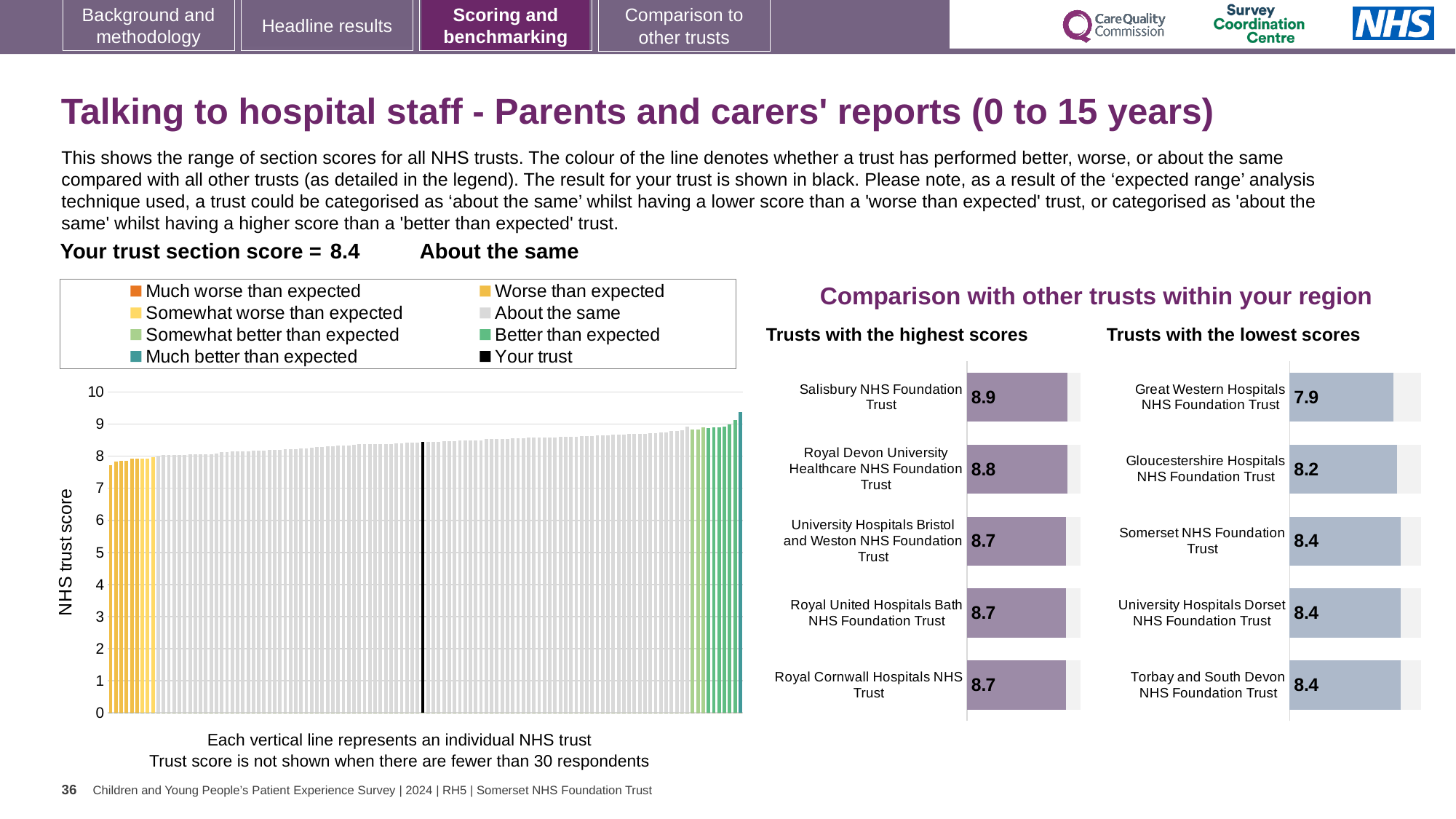
How many entries does the legend of the left-hand chart list? 8 In the 'Trusts with the highest scores' chart, what is the score for Salisbury NHS Foundation Trust? 8.9 In the 'Trusts with the lowest scores' chart, which trust has the lowest score? Great Western Hospitals NHS Foundation Trust In the 'Trusts with the lowest scores' chart, what is the score for Great Western Hospitals NHS Foundation Trust? 7.9 In the 'Trusts with the lowest scores' chart, what is the score for Somerset NHS Foundation Trust? 8.4 In the 'Trusts with the lowest scores' chart, what is the difference between the scores for Somerset NHS Foundation Trust and Gloucestershire Hospitals NHS Foundation Trust? 0.2 How many trusts are listed in the 'Trusts with the highest scores' chart? 5 What kind of chart is the large chart on the left showing NHS trust scores? Bar chart Which is larger: the score for Royal Devon University Healthcare NHS Foundation Trust in the highest scores chart or the score for Gloucestershire Hospitals NHS Foundation Trust in the lowest scores chart? Royal Devon University Healthcare NHS Foundation Trust In the 'Trusts with the highest scores' chart, which trust has the highest score? Salisbury NHS Foundation Trust In the left-hand chart, is the value of the lowest bar greater or less than 7? greater What is the difference between the score for Salisbury NHS Foundation Trust in the highest scores chart and the score for Great Western Hospitals NHS Foundation Trust in the lowest scores chart? 1.0